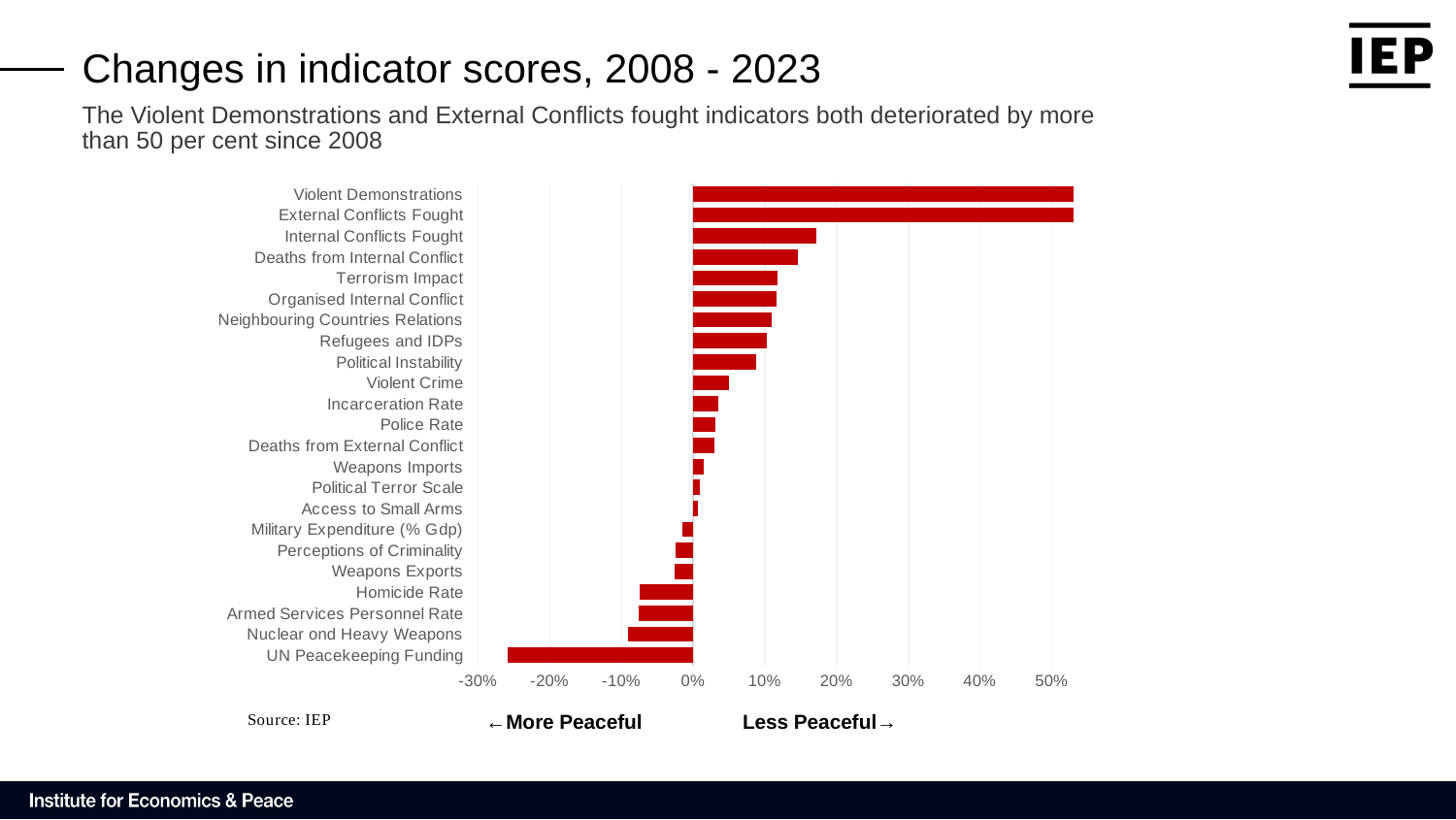
Which has the larger change in score, Political Instability or Violent Crime? Political Instability Is the value for Internal Conflicts Fought greater or less than 20%? less What is the title of the chart? Changes in indicator scores, 2008 - 2023 Is the value for UN Peacekeeping Funding greater or less than -20%? less Which indicator has the lowest (most negative) change in score? UN Peacekeeping Funding What source is cited for the chart? IEP What kind of chart is shown on the slide? Bar chart Is the value for Homicide Rate greater or less than -10%? greater How many indicators are plotted in the chart? 23 Which has the larger change in score, Internal Conflicts Fought or Terrorism Impact? Internal Conflicts Fought